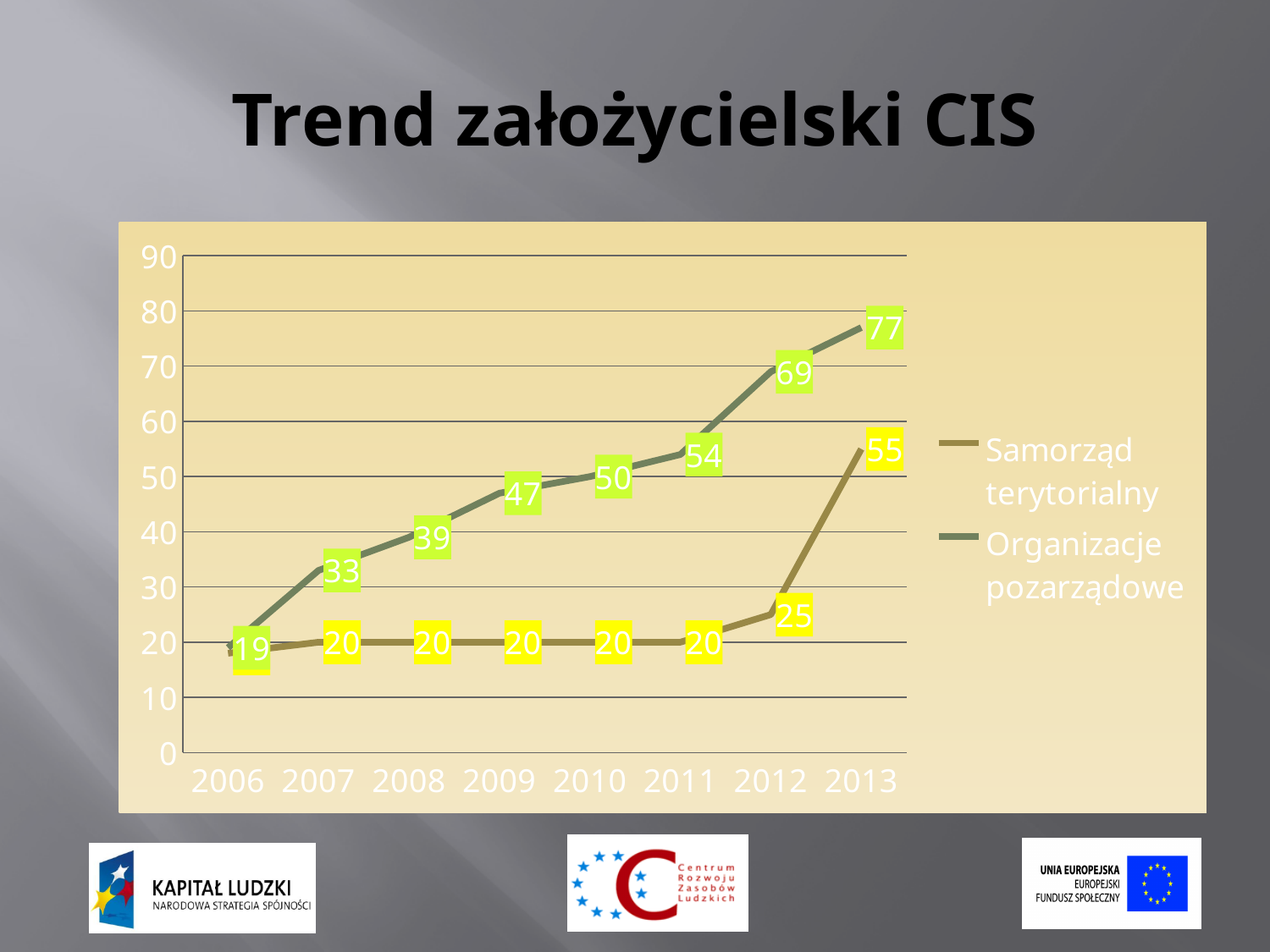
How many years are shown on the x axis? 8 In which year is the value for Organizacje pozarządowe lowest? 2006 What is the difference between Organizacje pozarządowe and Samorząd terytorialny in 2013? 22 What is the value for Organizacje pozarządowe in 2009? 47 How many series does the legend list? 2 What is the value for Samorząd terytorialny in 2013? 55 Does the value for Organizacje pozarządowe rise or fall from 2006 to 2013? rise Which series has the larger value in 2012, Samorząd terytorialny or Organizacje pozarządowe? Organizacje pozarządowe In which year is the value for Organizacje pozarządowe highest? 2013 What is the value for Samorząd terytorialny in 2012? 25 What is the value for Organizacje pozarządowe in 2013? 77 What type of chart is shown on the slide? line chart